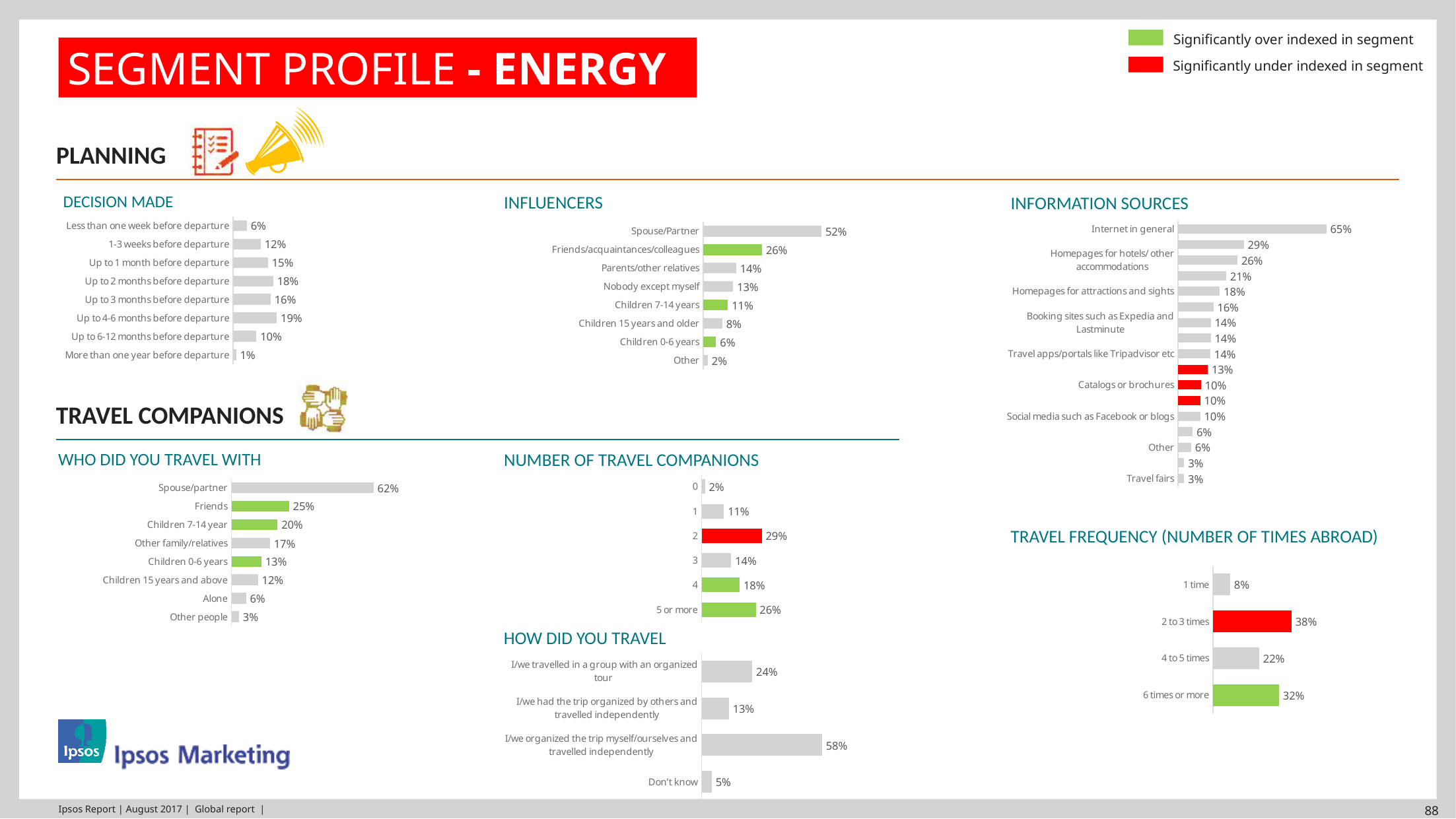
In the INFORMATION SOURCES chart, what is the value for 'Internet in general'? 65% In the HOW DID YOU TRAVEL chart, what is the value for 'I/we organized the trip myself/ourselves and travelled independently'? 58% In the TRAVEL FREQUENCY (NUMBER OF TIMES ABROAD) chart, which is larger: '2 to 3 times' or '6 times or more'? 2 to 3 times In the WHO DID YOU TRAVEL WITH chart, what is the difference between 'Spouse/partner' and 'Friends'? 37% What type of chart is the TRAVEL FREQUENCY (NUMBER OF TIMES ABROAD) chart? Bar chart In the INFLUENCERS chart, what is the value for 'Children 7-14 years'? 11% In the DECISION MADE chart, which category has the lowest value? More than one year before departure In the NUMBER OF TRAVEL COMPANIONS chart, what is the value for '5 or more'? 26% In the INFLUENCERS chart, which category has the highest value? Spouse/Partner In the NUMBER OF TRAVEL COMPANIONS chart, which category has the highest value? 2 In the DECISION MADE chart, what is the value for 'Up to 2 months before departure'? 18% In the WHO DID YOU TRAVEL WITH chart, how many categories are shown? 8